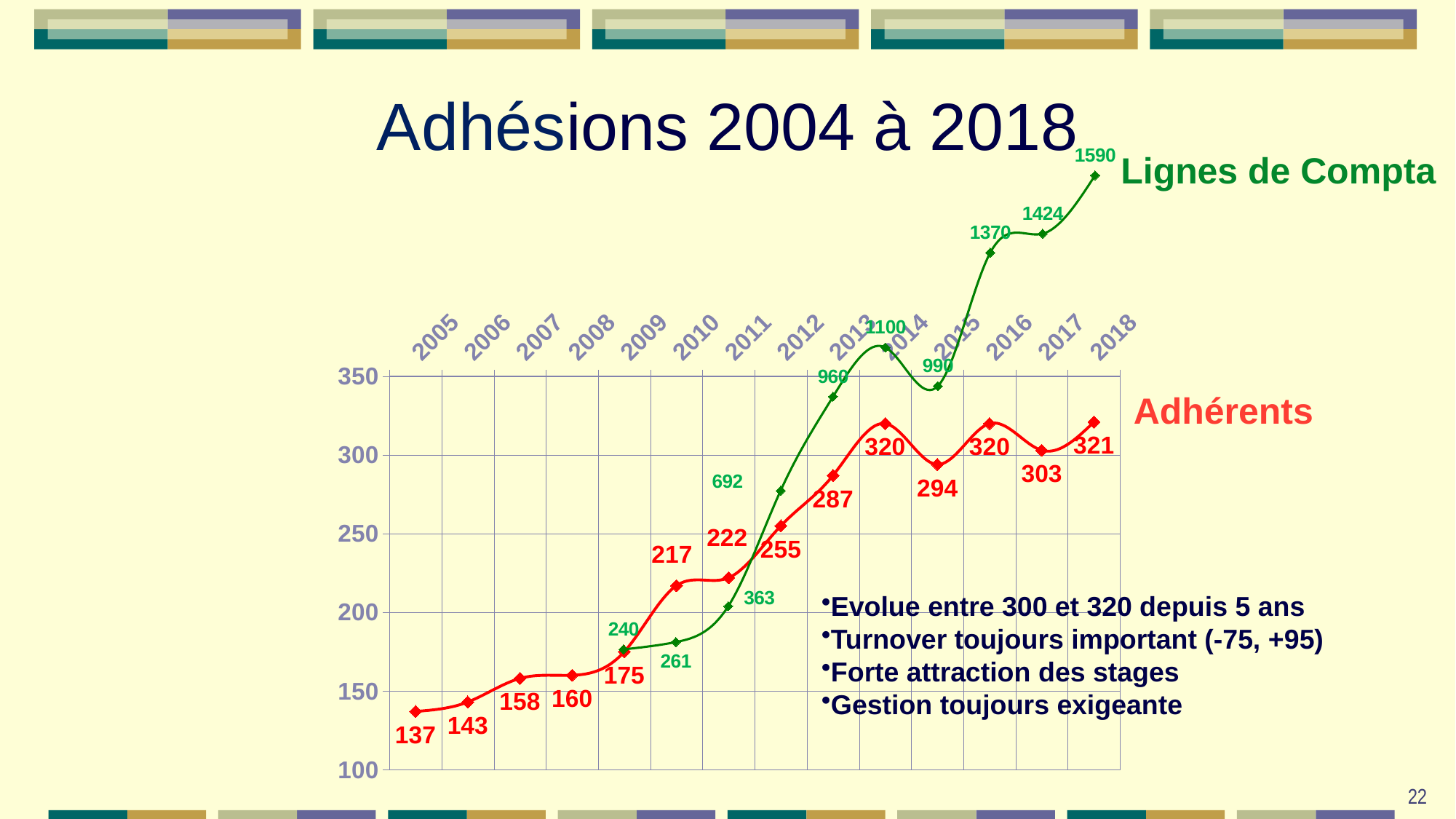
What colour is the Adhérents line? red What is the difference between the highest and lowest values of the Adhérents series? 184 How many series are plotted on the chart? 2 What is the highest value of the Lignes de Compta series? 1590 Overall, does the Adhérents series rise or fall from left to right? rise What is the lowest value of the Lignes de Compta series? 240 What is the difference between the last two values of the Lignes de Compta series, 1590 and 1424? 166 How many data points are labelled for the Lignes de Compta series? 10 What is the highest value of the Adhérents series? 321 What kind of chart is shown on the slide? line chart What is the lowest value of the Adhérents series? 137 In the Lignes de Compta series, which is larger: the value labelled 1100 or the value labelled 990? 1100